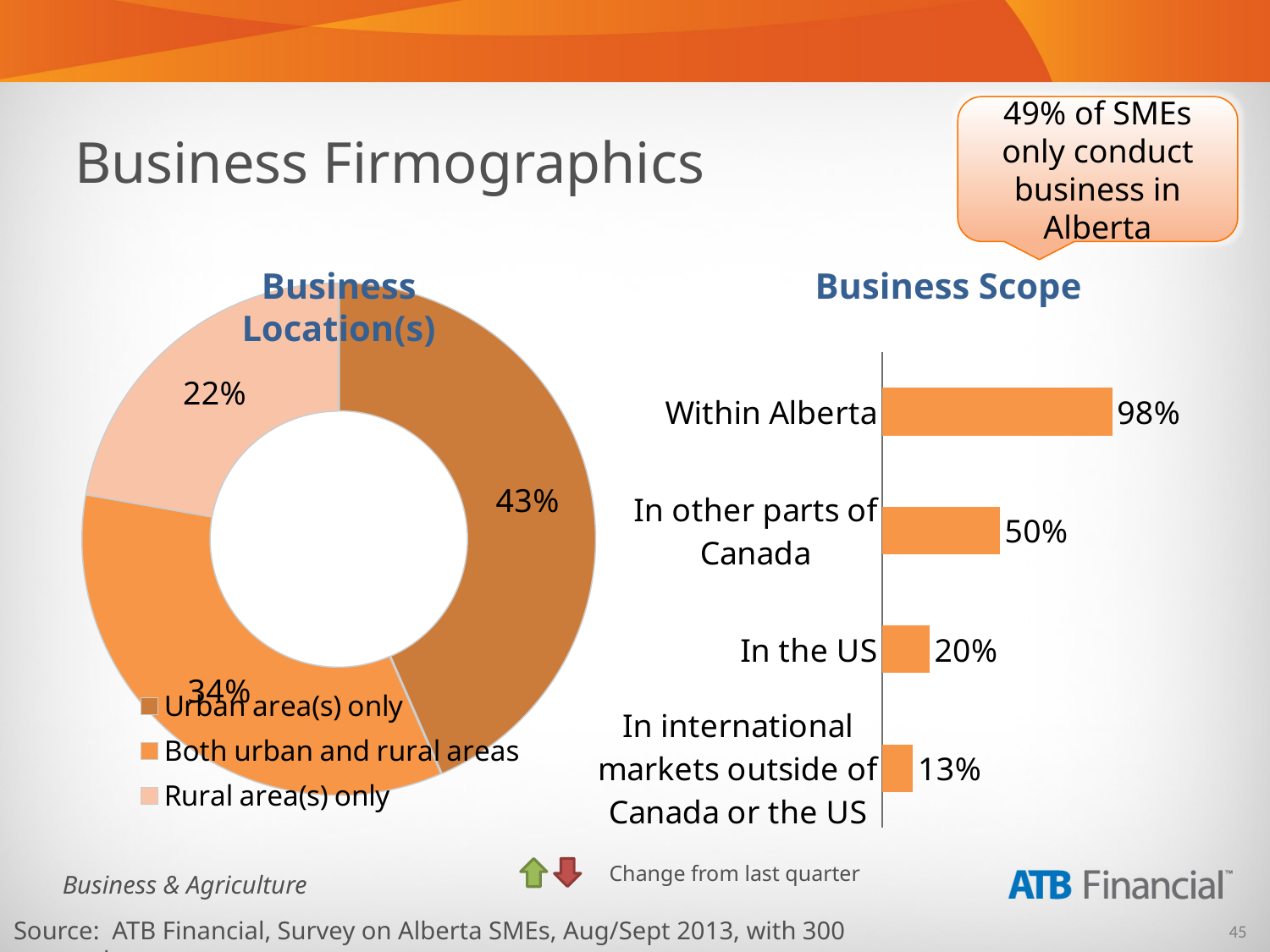
In the Business Location(s) chart, what share of SMEs are in urban area(s) only? 43% In the Business Scope chart, how many categories are shown? 4 In the Business Location(s) chart, which category has the largest share? Urban area(s) only In the Business Location(s) chart, which category has the smallest share? Rural area(s) only In the Business Scope chart, what is the difference between Within Alberta and In the US? 78% In the Business Scope chart, what is the value for In other parts of Canada? 50% In the Business Location(s) chart, what share of SMEs operate in both urban and rural areas? 34% What kind of chart is the Business Scope chart? Bar chart In the Business Location(s) chart, what share of SMEs are in rural area(s) only? 22% In the Business Scope chart, what is the value for In international markets outside of Canada or the US? 13% What kind of chart is the Business Location(s) chart? Doughnut chart In the Business Scope chart, what is the value for Within Alberta? 98%